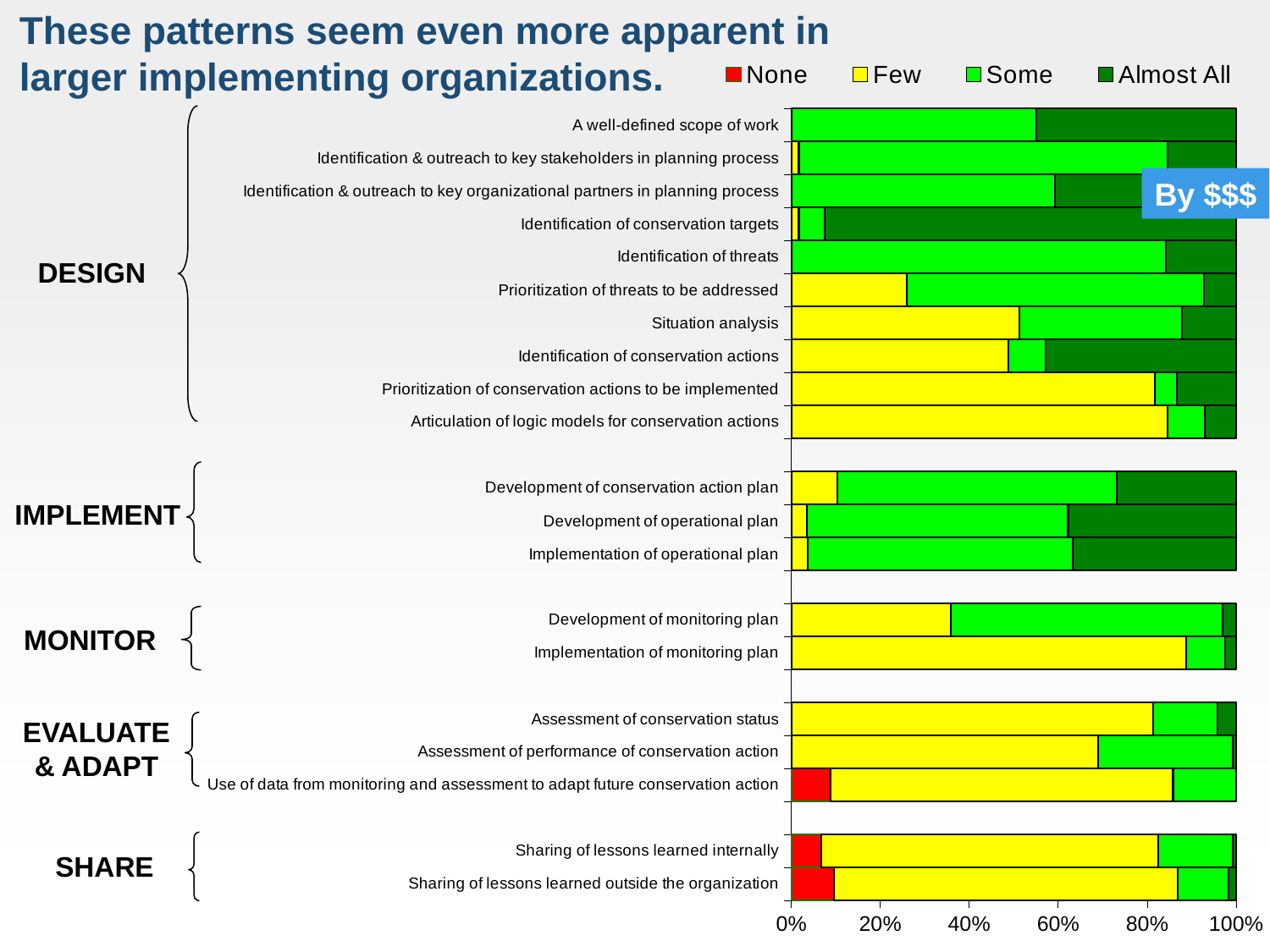
What kind of chart is shown on the slide? Stacked bar chart Which colour represents the 'None' series in the legend? Red Is the 'Some' value for 'Identification of threats' greater or less than 80%? greater What label appears in the blue box at the top right of the chart? By $$$ Is the 'Few' value for 'Articulation of logic models for conservation actions' greater or less than 80%? greater Is the 'Few' value for 'Development of monitoring plan' greater or less than 40%? less Which category has the largest 'Almost All' segment? Identification of conservation targets Which has the larger 'Few' segment: 'Implementation of monitoring plan' or 'Development of monitoring plan'? Implementation of monitoring plan How many series does the legend list? 4 How many categories (practices) are plotted in the chart? 20